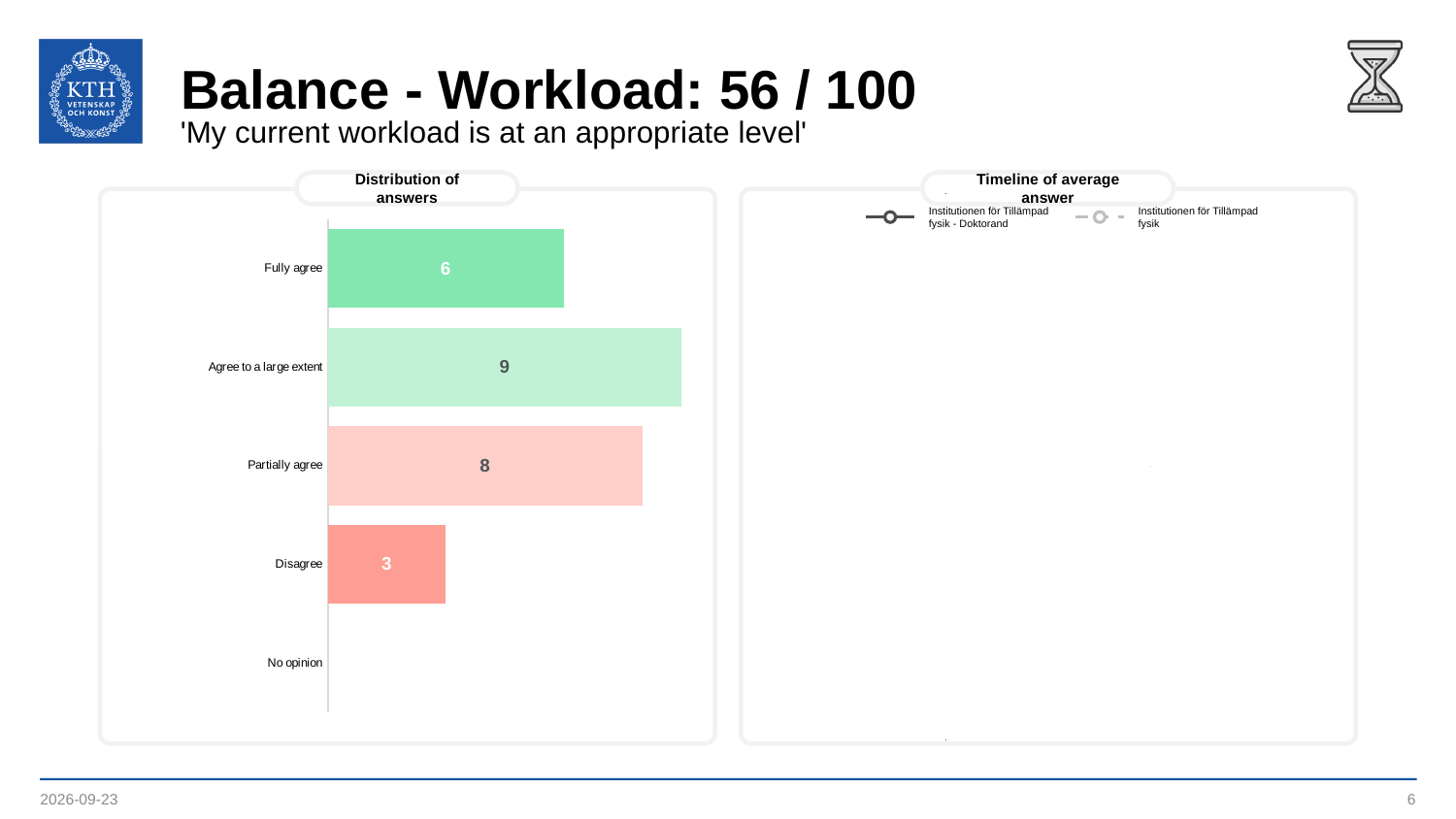
In the 'Distribution of answers' chart, what is the difference between 'Agree to a large extent' and 'Disagree'? 6 In the 'Distribution of answers' chart, what is the value for 'Agree to a large extent'? 9 What is the title of the chart on the left side of the slide? Distribution of answers In the 'Distribution of answers' chart, which category with a bar has the lowest value? Disagree In the 'Distribution of answers' chart, which is larger: 'Fully agree' or 'Partially agree'? Partially agree In the 'Distribution of answers' chart, how many categories are listed on the axis? 5 In the 'Distribution of answers' chart, what is the value for 'Disagree'? 3 How many series does the legend of the 'Timeline of average answer' chart list? 2 What kind of chart is the 'Distribution of answers' chart? Bar chart In the 'Distribution of answers' chart, which category has the highest value? Agree to a large extent In the 'Distribution of answers' chart, what is the value for 'Partially agree'? 8 In the 'Distribution of answers' chart, what is the value for 'Fully agree'? 6